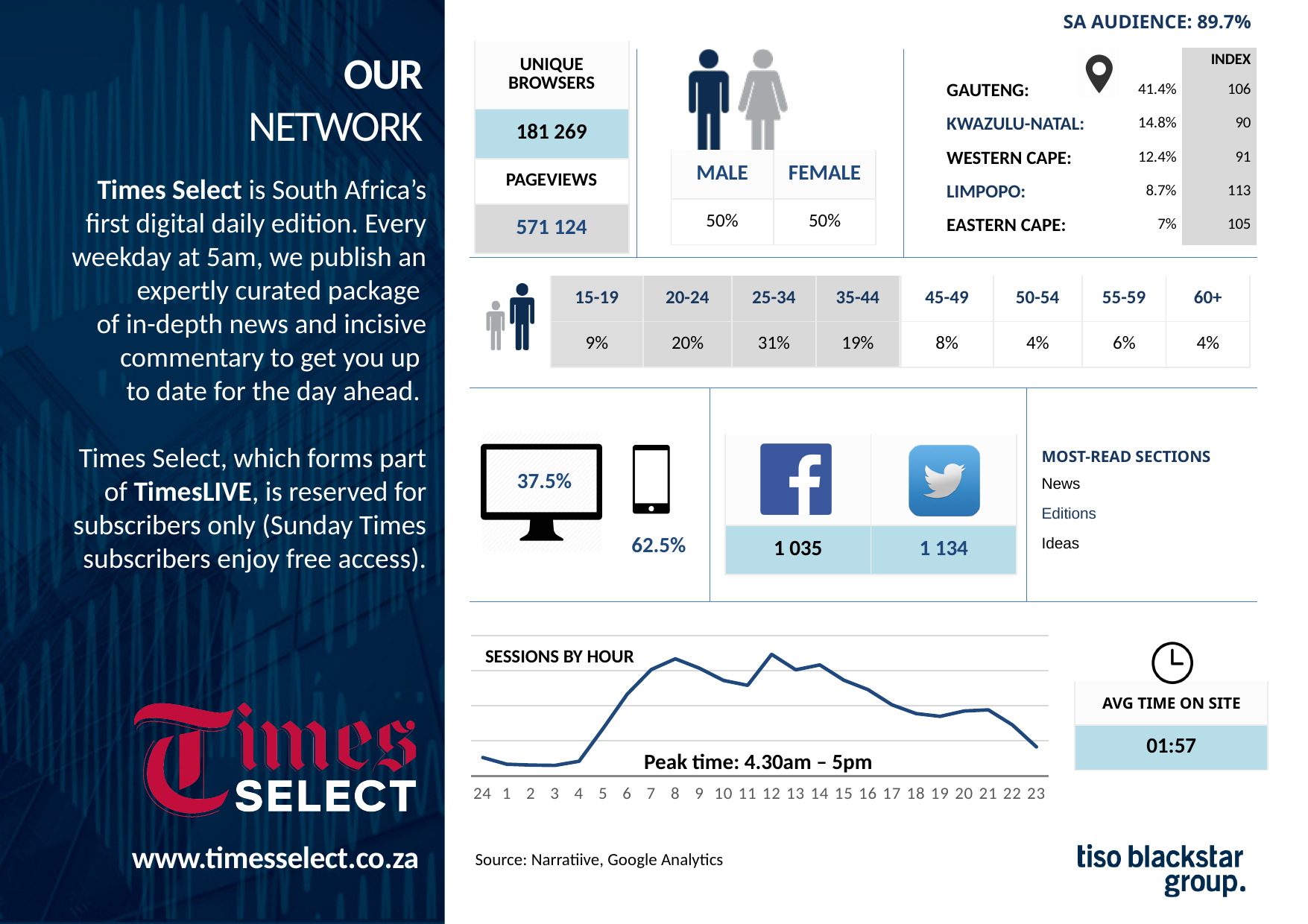
How many lines are plotted on the 'Sessions by hour' chart? 1 How many hour labels are shown on the x axis of the 'Sessions by hour' chart? 24 What kind of chart is the 'Sessions by hour' chart? line chart On the 'Sessions by hour' chart, do sessions rise or fall between hour 4 and hour 8? rise What is the last label on the x axis of the 'Sessions by hour' chart? 23 On the 'Sessions by hour' chart, which hour has more sessions, hour 16 or hour 22? hour 16 What is the title of the line chart at the bottom of the slide? SESSIONS BY HOUR On the 'Sessions by hour' chart, which hour has more sessions, hour 3 or hour 8? hour 8 What peak time is annotated on the 'Sessions by hour' chart? 4.30am – 5pm What is the first label on the x axis of the 'Sessions by hour' chart? 24 On the 'Sessions by hour' chart, do sessions rise or fall between hour 12 and hour 23? fall On the 'Sessions by hour' chart, which hour has more sessions, hour 12 or hour 18? hour 12